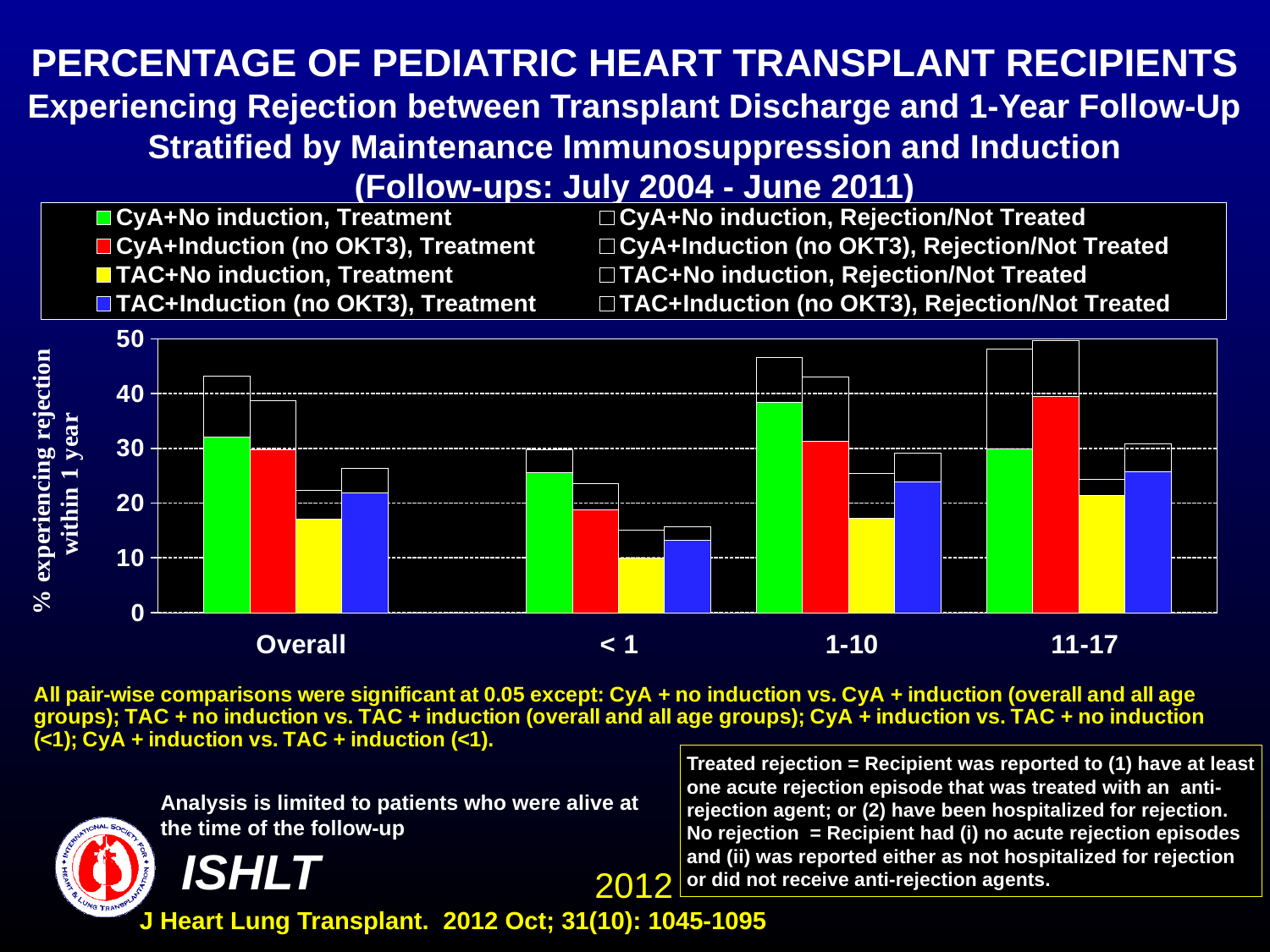
In the Overall group, which treatment series has the lowest value? TAC+No induction, Treatment How many categories are shown along the x axis? 4 How many series does the legend list? 8 Is the value for CyA+No induction, Treatment in the Overall group greater or less than 30? greater In the < 1 age group, which treatment series has the highest value? CyA+No induction, Treatment Is the value for CyA+Induction (no OKT3), Treatment in the < 1 group greater or less than 20? less Is the value for CyA+No induction, Treatment in the 1-10 group greater or less than 40? less In the 11-17 age group, which treatment series has the highest value? CyA+Induction (no OKT3), Treatment Does the value for TAC+No induction, Treatment rise or fall across the age groups < 1, 1-10 and 11-17? rise What kind of chart is shown on the slide? bar chart